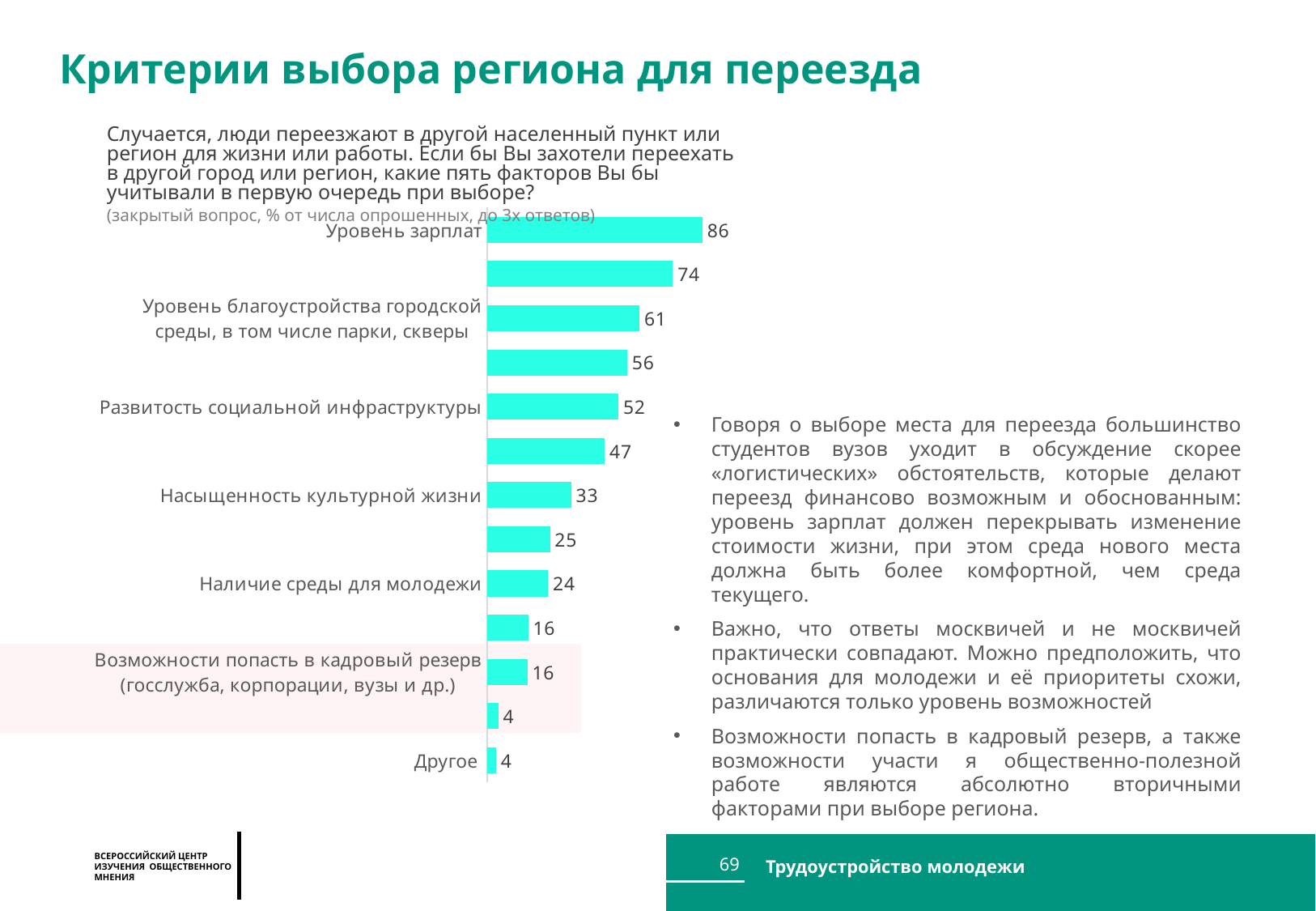
What is the difference between the values for «Уровень благоустройства городской среды, в том числе парки, скверы» and «Развитость социальной инфраструктуры»? 9 How many bars are plotted in the chart? 13 What is the value for «Возможности попасть в кадровый резерв (госслужба, корпорации, вузы и др.)»? 16 What is the value for «Развитость социальной инфраструктуры»? 52 What is the value for «Другое»? 4 Which category has the highest value in the chart? Уровень зарплат What is the difference between the values for «Уровень зарплат» and «Другое»? 82 What is the value for «Наличие среды для молодежи»? 24 What is the value for «Насыщенность культурной жизни»? 33 What is the value for «Уровень благоустройства городской среды, в том числе парки, скверы»? 61 What is the value for «Уровень зарплат»? 86 Which is larger: the value for «Насыщенность культурной жизни» or for «Наличие среды для молодежи»? Насыщенность культурной жизни